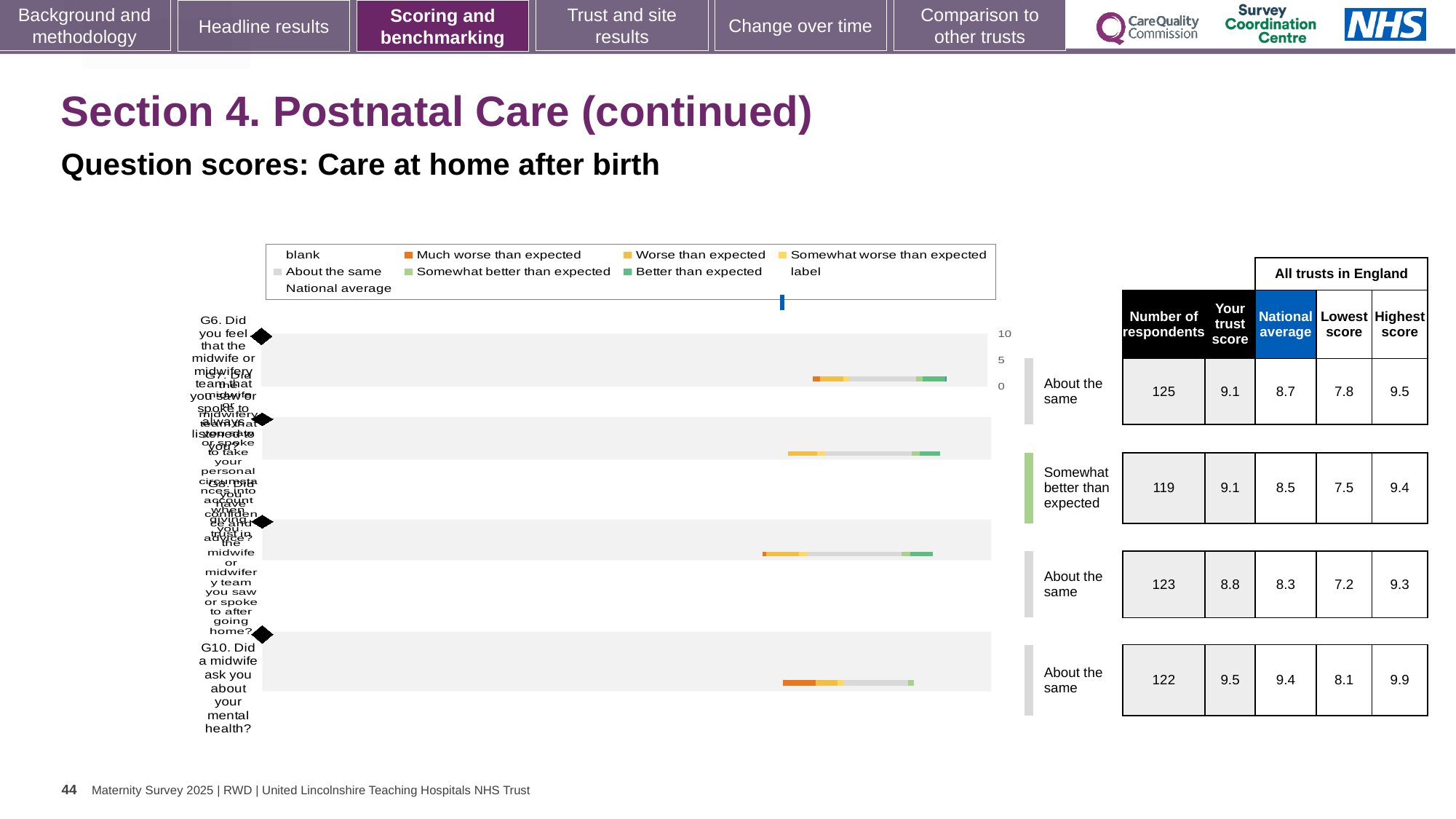
What is the trust score for question G6, the first row of the chart? 9.1 Which question row has the highest trust score? G10 What is the trust score for question G10 (Did a midwife ask you about your mental health?)? 9.5 Which is larger for question G6: the trust score or the national average? trust score What is the difference between the trust score and the national average for the third row of the chart (G8)? 0.5 What is the highest score among all trusts in England for question G10? 9.9 How many respondents answered question G6, the first row of the chart? 125 What is the national average for question G10 (Did a midwife ask you about your mental health?)? 9.4 How many question rows (bars) are plotted in the chart? 4 What kind of chart is shown on the slide? bar chart What is the lowest score among all trusts in England for the third row of the chart (G8)? 7.2 Which benchmark category is shown for the second row of the chart (G7)? Somewhat better than expected